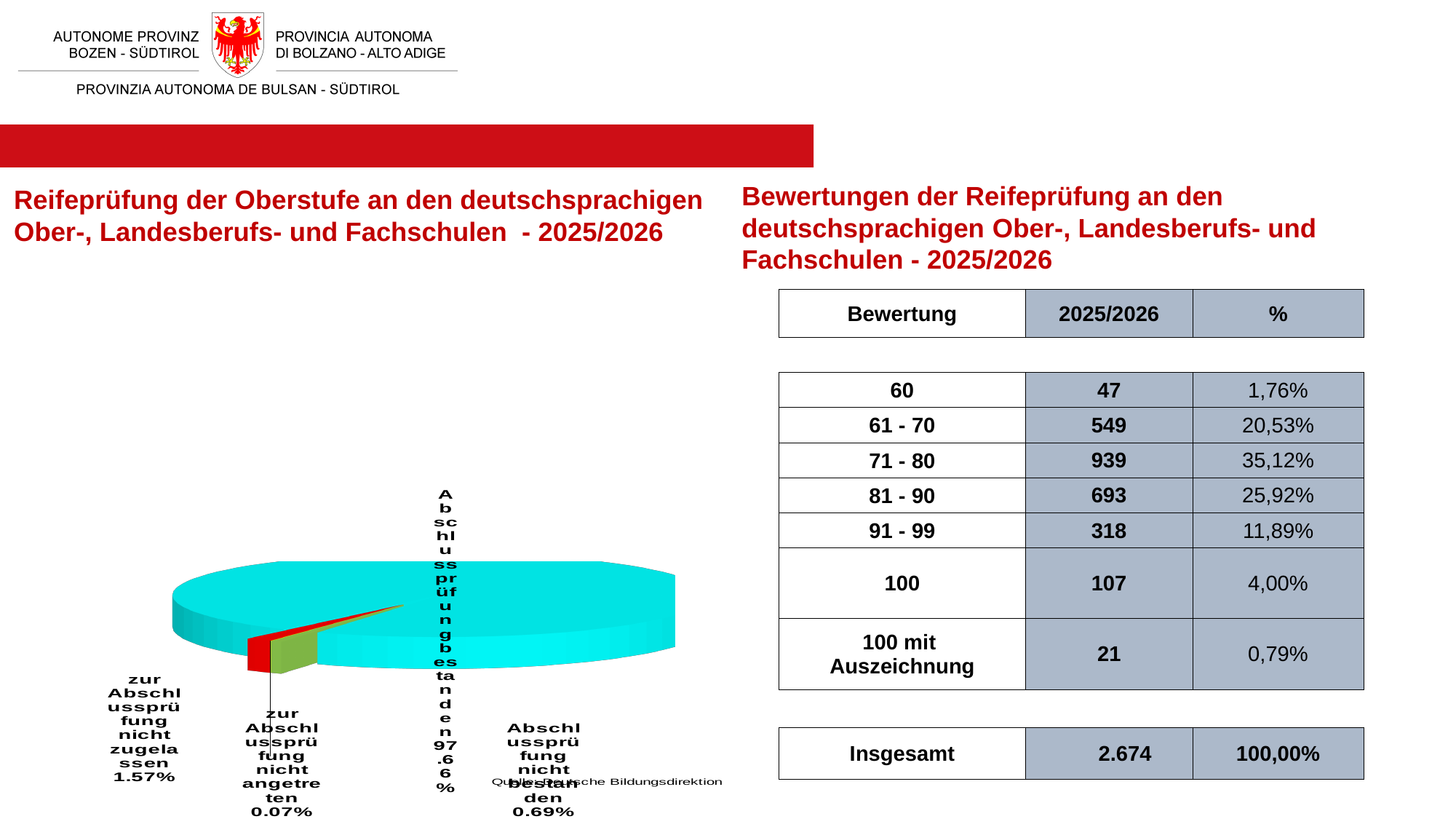
How many slices does the pie chart have? 4 Which slice of the pie chart is the smallest? zur Abschlussprüfung nicht angetreten What colour is the largest slice of the pie chart? Cyan What kind of chart is shown on the left of the slide? Pie chart In the pie chart, which is larger: "zur Abschlussprüfung nicht zugelassen" or "Abschlussprüfung nicht bestanden"? zur Abschlussprüfung nicht zugelassen In the pie chart, what share is labelled for "zur Abschlussprüfung nicht angetreten"? 0.07% In the pie chart, what share is labelled for "zur Abschlussprüfung nicht zugelassen"? 1.57% In the pie chart, what is the difference between the shares for "zur Abschlussprüfung nicht zugelassen" and "Abschlussprüfung nicht bestanden"? 0.88% Which slice of the pie chart is the largest? Abschlussprüfung bestanden In the pie chart, what share is labelled for "Abschlussprüfung nicht bestanden"? 0.69% In the pie chart, what share is labelled for "Abschlussprüfung bestanden"? 97.66% What is the title above the pie chart? Reifeprüfung der Oberstufe an den deutschsprachigen Ober-, Landesberufs- und Fachschulen - 2025/2026